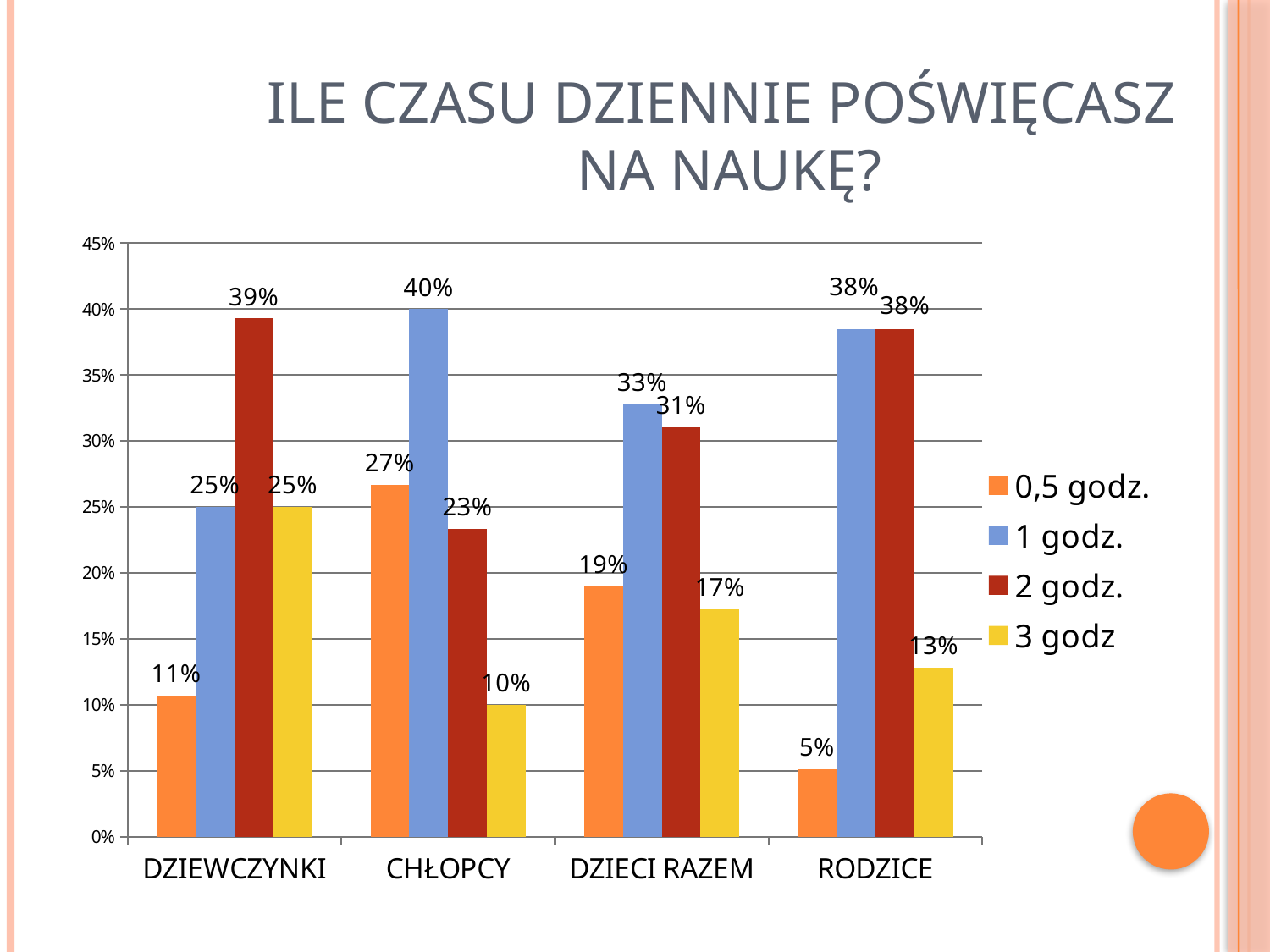
How many categories are shown on the x axis? 4 What is the value for 2 godz. in the DZIEWCZYNKI category? 39% What is the value for 3 godz in the DZIECI RAZEM category? 17% What is the difference between the 1 godz. and 0,5 godz. values for RODZICE? 33% How many series does the legend list? 4 What colour are the bars for the 2 godz. series? Dark red What is the value for 0,5 godz. in the RODZICE category? 5% Which category has the lowest value for 3 godz? CHŁOPCY What kind of chart is shown on the slide? Bar chart What is the value for 1 godz. in the CHŁOPCY category? 40% Which category has the highest value for 0,5 godz.? CHŁOPCY Which is larger for DZIECI RAZEM: the 1 godz. value or the 2 godz. value? 1 godz.